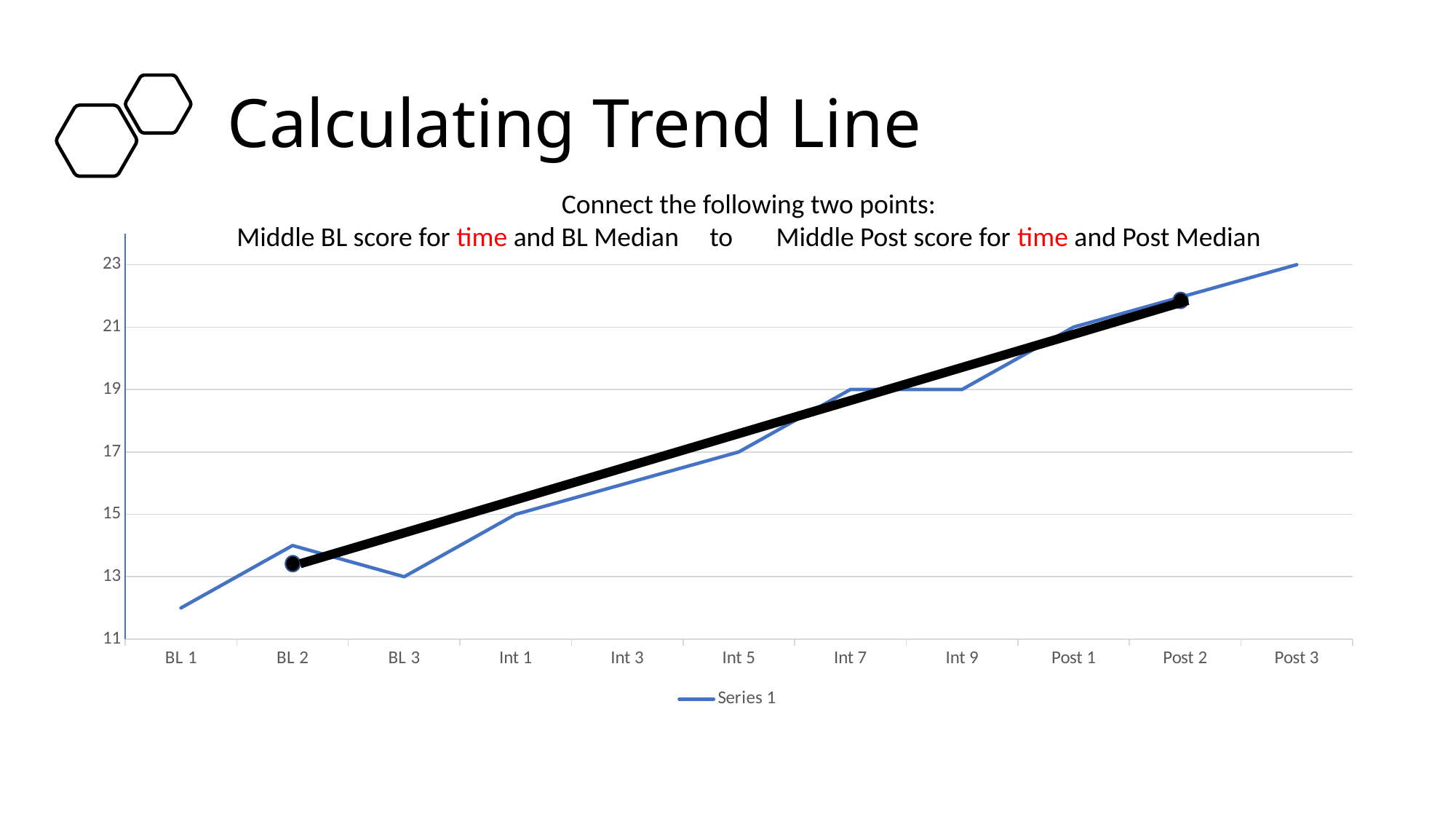
Which category has the lowest value? BL 1 Do the values generally rise or fall from BL 1 to Post 3? rise What kind of chart is shown on the slide? line chart What is the value for Int 7? 19 What is the value for Post 3? 23 Is the value for Post 2 greater or less than 21? greater How many series does the chart legend list? 1 What is the difference between the values for Post 3 and BL 3? 10 Which category has the highest value? Post 3 What is the value for BL 3? 13 How many categories are shown on the x axis of the chart? 11 Is the value for BL 1 greater or less than 13? less